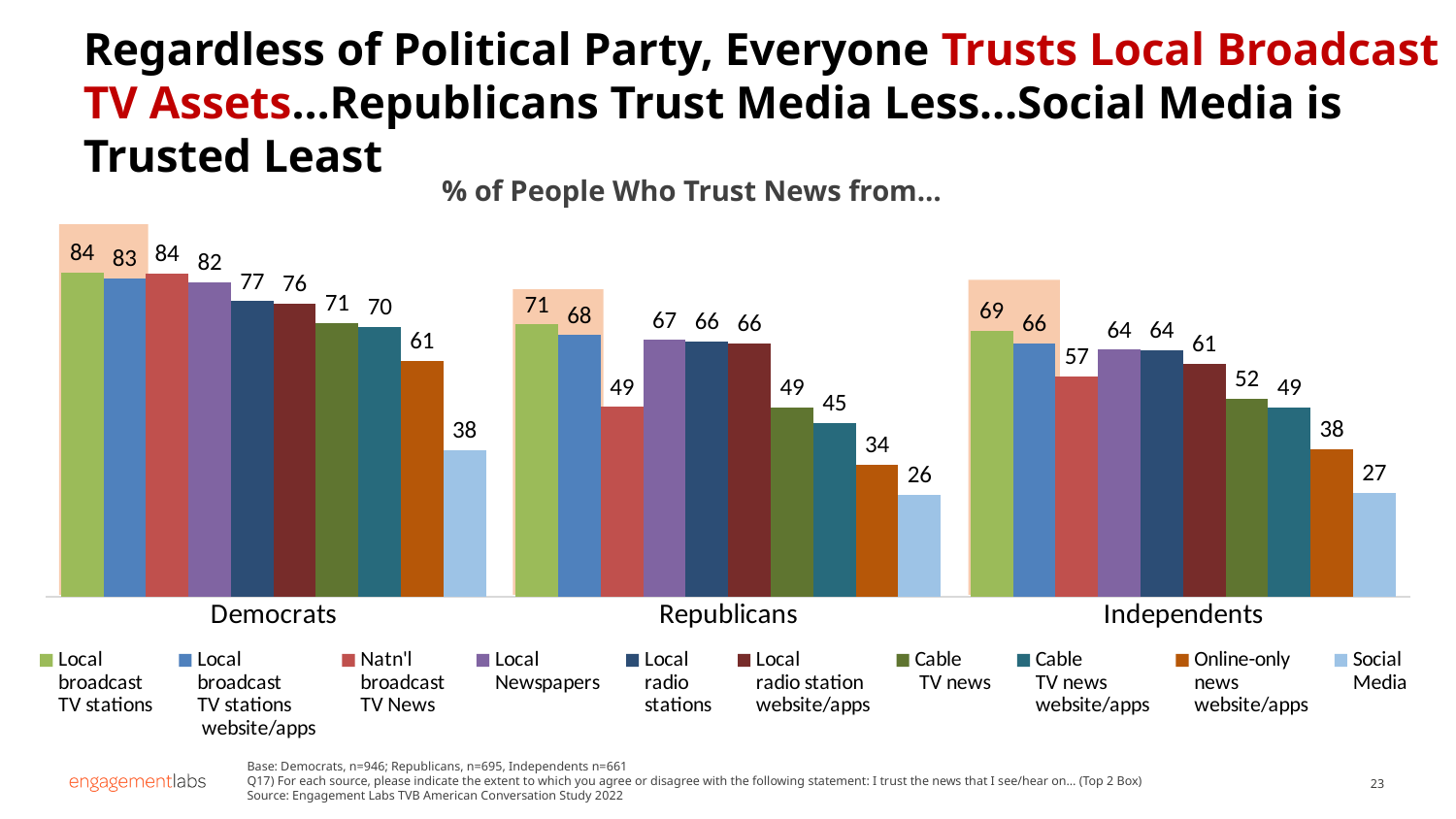
What percentage of Democrats trust news from Online-only news website/apps? 61 How many series does the legend list? 10 Which news source has the lowest trust value among Republicans? Social Media What is the difference between the Democrats' and Republicans' values for Cable TV news? 22 Which news source has the highest trust value among Independents? Local broadcast TV stations What is the difference between the Independents' values for Local broadcast TV stations and Social Media? 42 What is the subtitle printed above the chart? % of People Who Trust News from... Which is larger: the Republicans' value for Local Newspapers or the Independents' value for Local Newspapers? Republicans What percentage of Independents trust news from Natn'l broadcast TV News? 57 How many political groups are shown on the x axis? 3 What kind of chart is shown on the slide? Bar chart What percentage of Republicans trust news from Social Media? 26